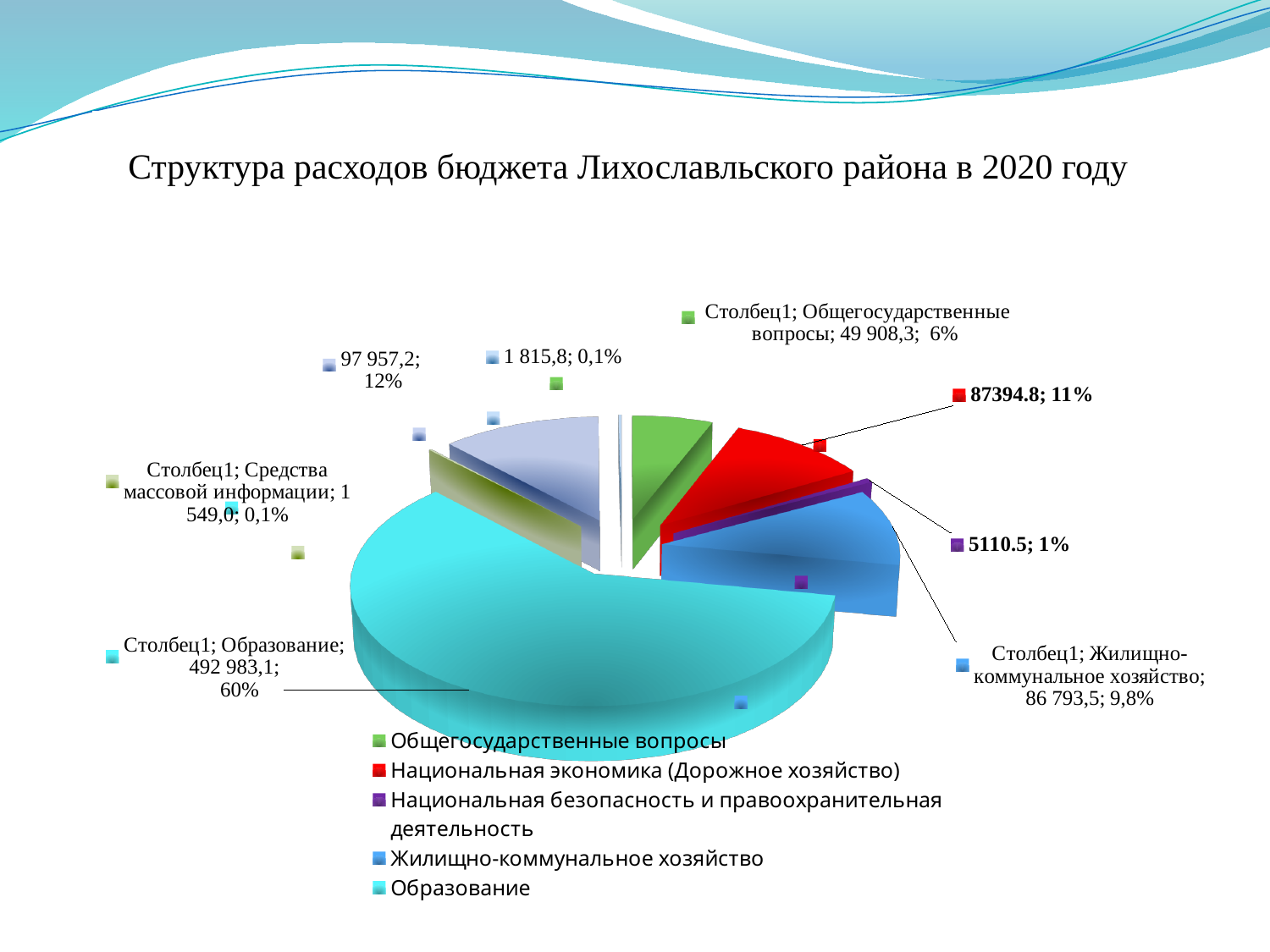
What share of the pie does Жилищно-коммунальное хозяйство take? 9,8% How many entries does the chart legend list? 5 What type of chart is shown on the slide? pie chart What is the title of the chart? Структура расходов бюджета Лихославльского района в 2020 году What value is shown for Образование? 492 983,1 What value is shown for Жилищно-коммунальное хозяйство? 86 793,5 Which is larger, the share for Общегосударственные вопросы or the share for Жилищно-коммунальное хозяйство? Жилищно-коммунальное хозяйство What value is shown for Общегосударственные вопросы? 49 908,3 What share of the pie does Образование take? 60% Which category has the largest slice of the pie? Образование What value is shown for Средства массовой информации? 1 549,0 What is the difference between the values for Общегосударственные вопросы and Средства массовой информации? 48 359,3